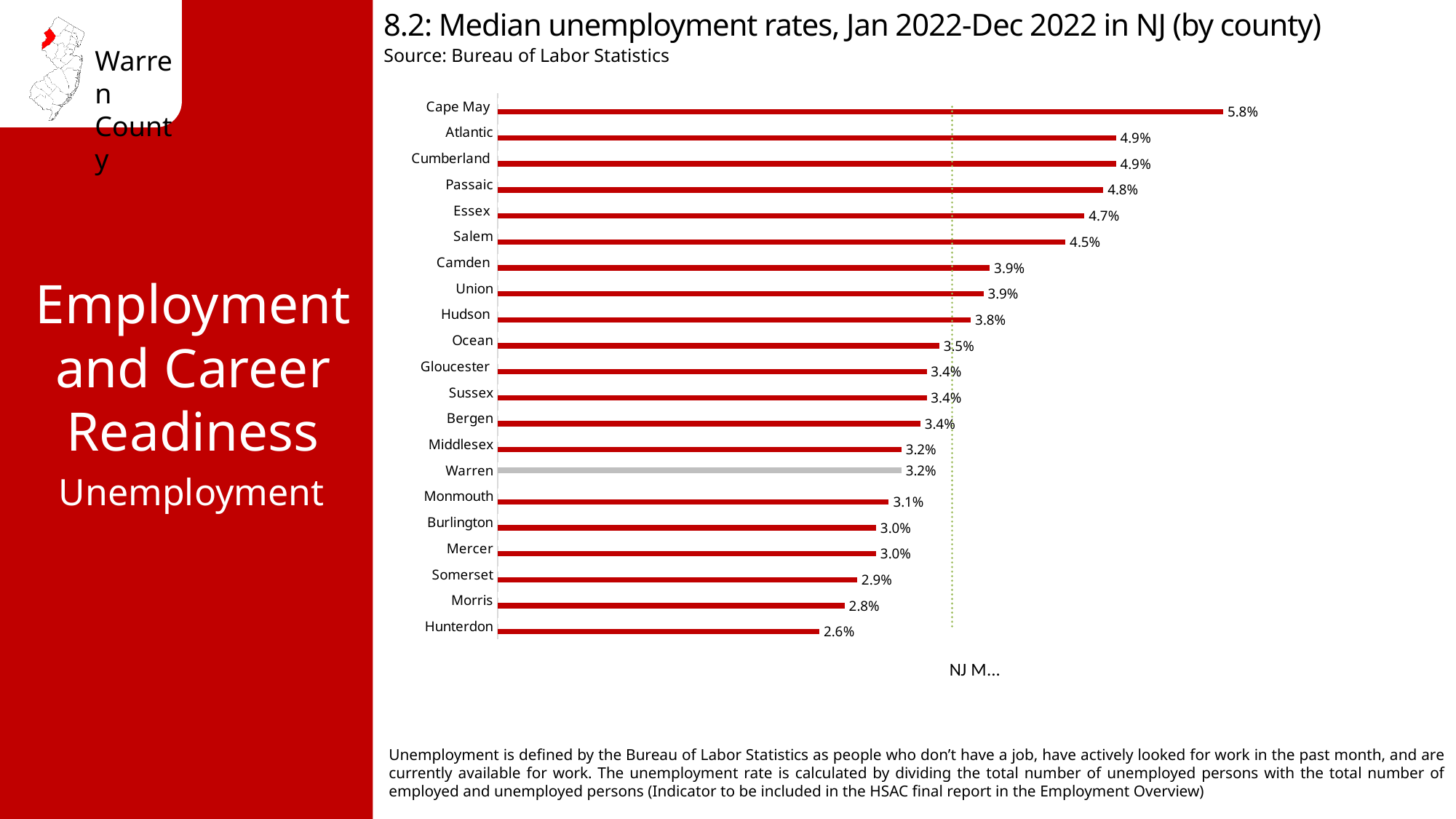
What is the median unemployment rate for Hudson? 3.8% What is the median unemployment rate for Warren County? 3.2% Which county has the lowest median unemployment rate? Hunterdon Which has a higher median unemployment rate, Morris or Monmouth? Monmouth How many counties are shown in the chart? 21 What is the difference between the median unemployment rates of Cape May and Hunterdon? 3.2% What is the difference between the median unemployment rates of Salem and Warren? 1.3% Which has a higher median unemployment rate, Essex or Camden? Essex Which county has the highest median unemployment rate? Cape May What is the median unemployment rate for Cape May? 5.8% Which county's bar is shown in grey rather than red? Warren What type of chart is shown on the slide? Bar chart